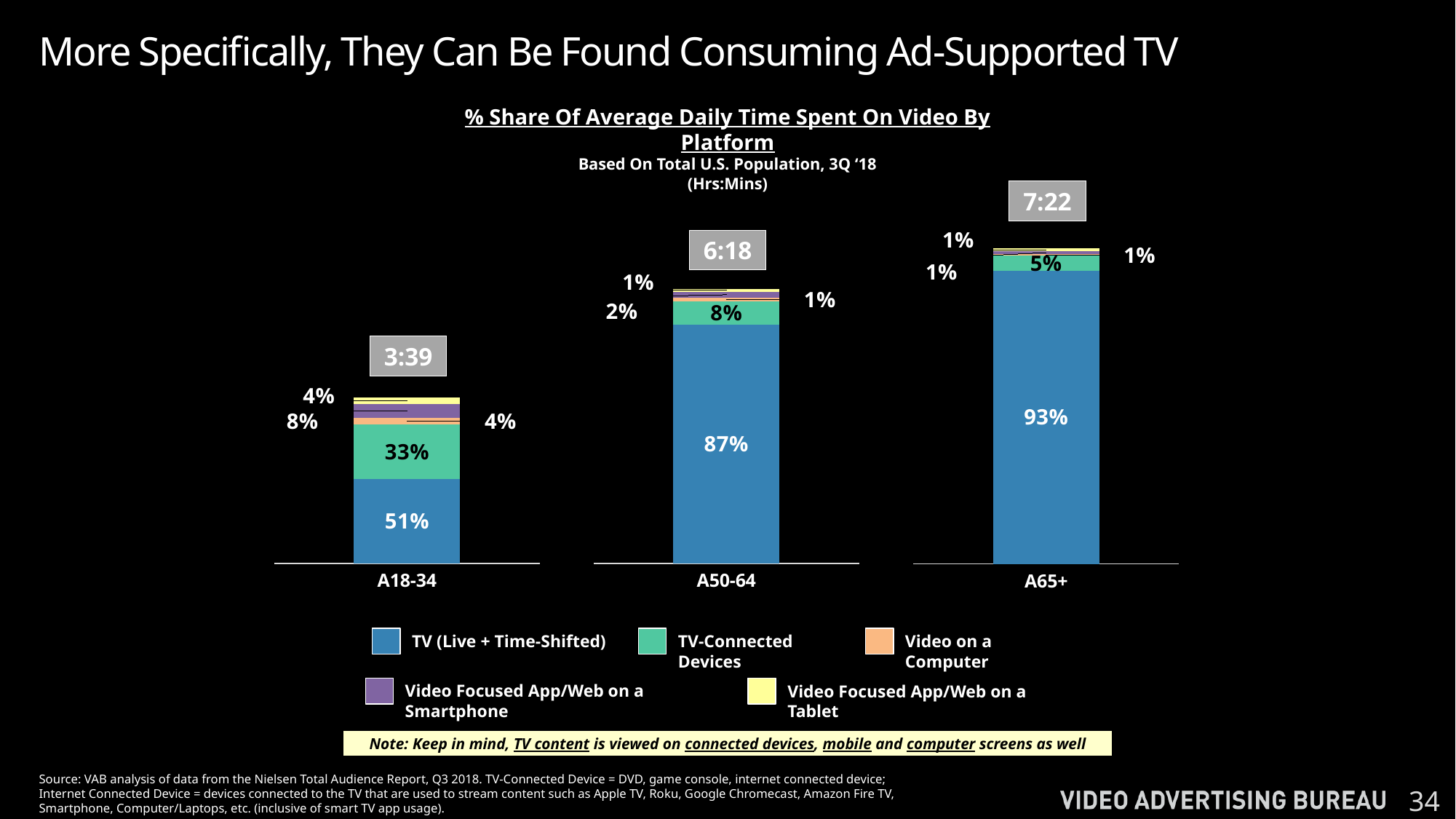
What is the TV-Connected Devices share for the A18-34 group? 33% How many platform series does the legend list? 5 What share of average daily video time does TV (Live + Time-Shifted) account for among A65+? 93% Which age group has the lowest total average daily time spent on video? A18-34 How many age groups are shown on the chart? 3 What share of average daily video time does TV (Live + Time-Shifted) account for among A18-34? 51% What is the average daily time spent on video (Hrs:Mins) shown above the A50-64 bar? 6:18 Does the TV (Live + Time-Shifted) share rise or fall moving from A18-34 to A65+? rise Which group has a larger TV-Connected Devices share, A18-34 or A65+? A18-34 What is the TV-Connected Devices share for the A50-64 group? 8% What is the difference in TV (Live + Time-Shifted) share between A65+ and A18-34? 42 percentage points Which age group has the highest TV (Live + Time-Shifted) share? A65+